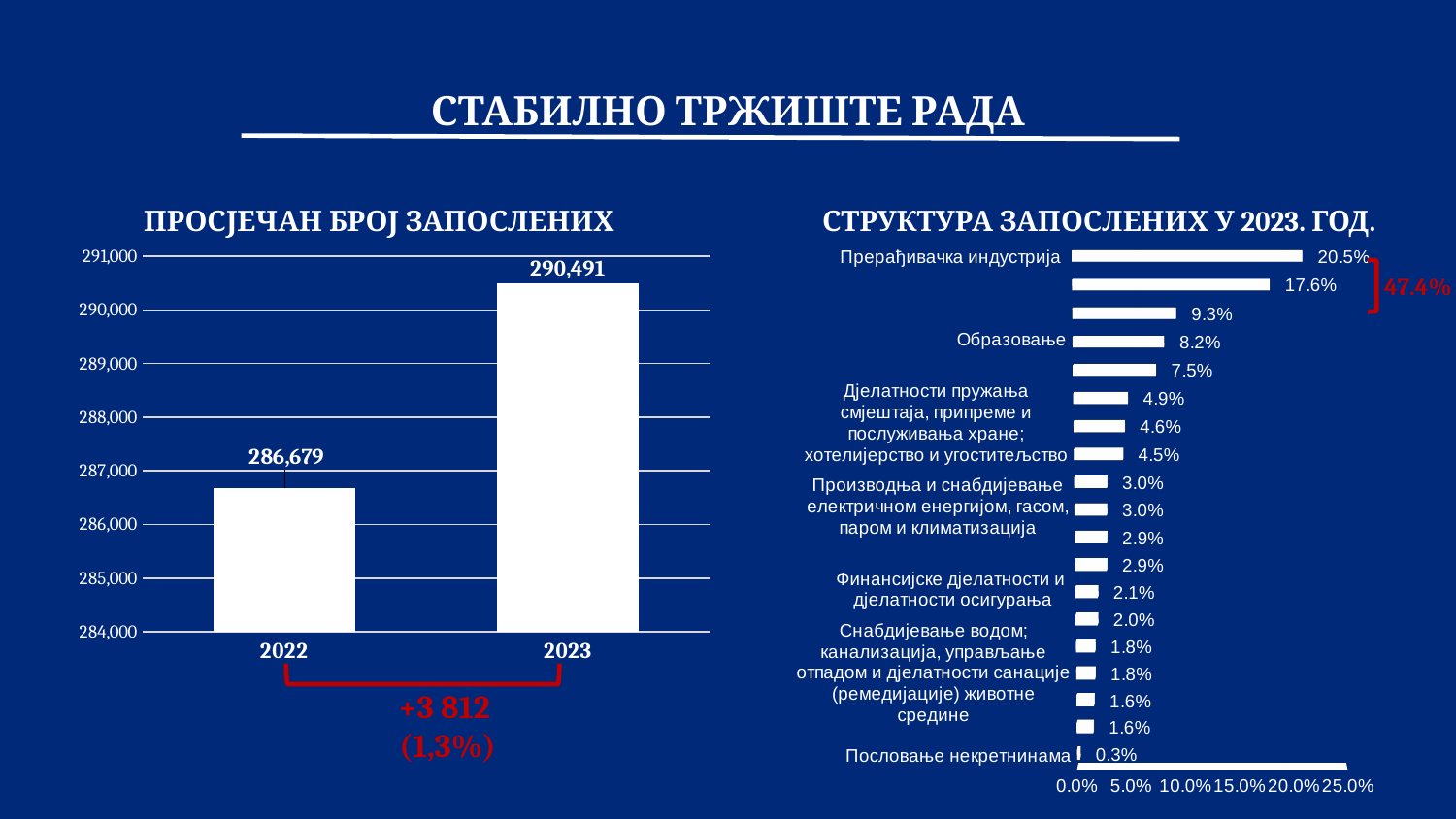
In the chart titled ПРОСЈЕЧАН БРОЈ ЗАПОСЛЕНИХ, do the values rise or fall from 2022 to 2023? rise In the chart titled СТРУКТУРА ЗАПОСЛЕНИХ У 2023. ГОД., which category has the lowest value? Пословање некретнинама In the chart titled ПРОСЈЕЧАН БРОЈ ЗАПОСЛЕНИХ, what is the value for 2023? 290,491 In the chart titled СТРУКТУРА ЗАПОСЛЕНИХ У 2023. ГОД., which category has the highest value? Прерађивачка индустрија In the chart titled ПРОСЈЕЧАН БРОЈ ЗАПОСЛЕНИХ, what is the difference between the 2023 and 2022 values? 3,812 In the chart titled СТРУКТУРА ЗАПОСЛЕНИХ У 2023. ГОД., what is the value for Прерађивачка индустрија? 20.5% In the chart titled ПРОСЈЕЧАН БРОЈ ЗАПОСЛЕНИХ, what is the value for 2022? 286,679 In the chart titled СТРУКТУРА ЗАПОСЛЕНИХ У 2023. ГОД., what is the value for Пословање некретнинама? 0.3% In the chart titled ПРОСЈЕЧАН БРОЈ ЗАПОСЛЕНИХ, which year has the higher value, 2022 or 2023? 2023 In the chart titled СТРУКТУРА ЗАПОСЛЕНИХ У 2023. ГОД., what is the value for Образовање? 8.2% How many bars are in the chart titled ПРОСЈЕЧАН БРОЈ ЗАПОСЛЕНИХ? 2 What kind of chart is the one titled ПРОСЈЕЧАН БРОЈ ЗАПОСЛЕНИХ? bar chart